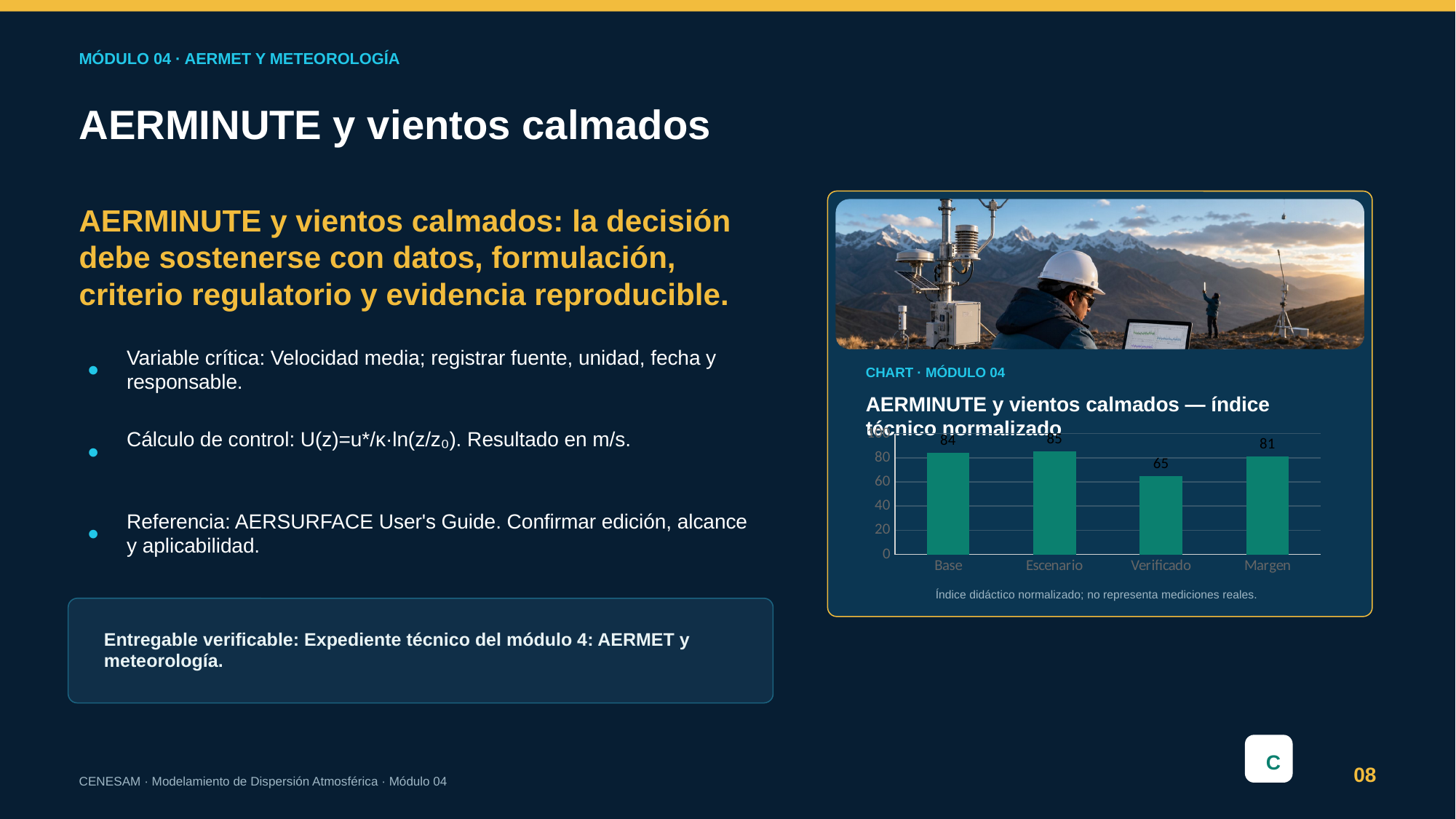
What is the difference between the values for Margen and Verificado? 16 Which is larger, the value for Margen or the value for Verificado? Margen Is the value for Verificado greater or less than 80? less How many categories are shown on the x axis of the chart? 4 What is the title of the chart? AERMINUTE y vientos calmados — índice técnico normalizado What is the value for Verificado in the chart? 65 What is the value for Base in the chart? 84 What is the value for Margen in the chart? 81 Which is larger, the value for Base or the value for Verificado? Base What is the difference between the values for Base and Verificado? 19 What kind of chart is shown on the slide? bar chart Which category has the lowest value in the chart? Verificado